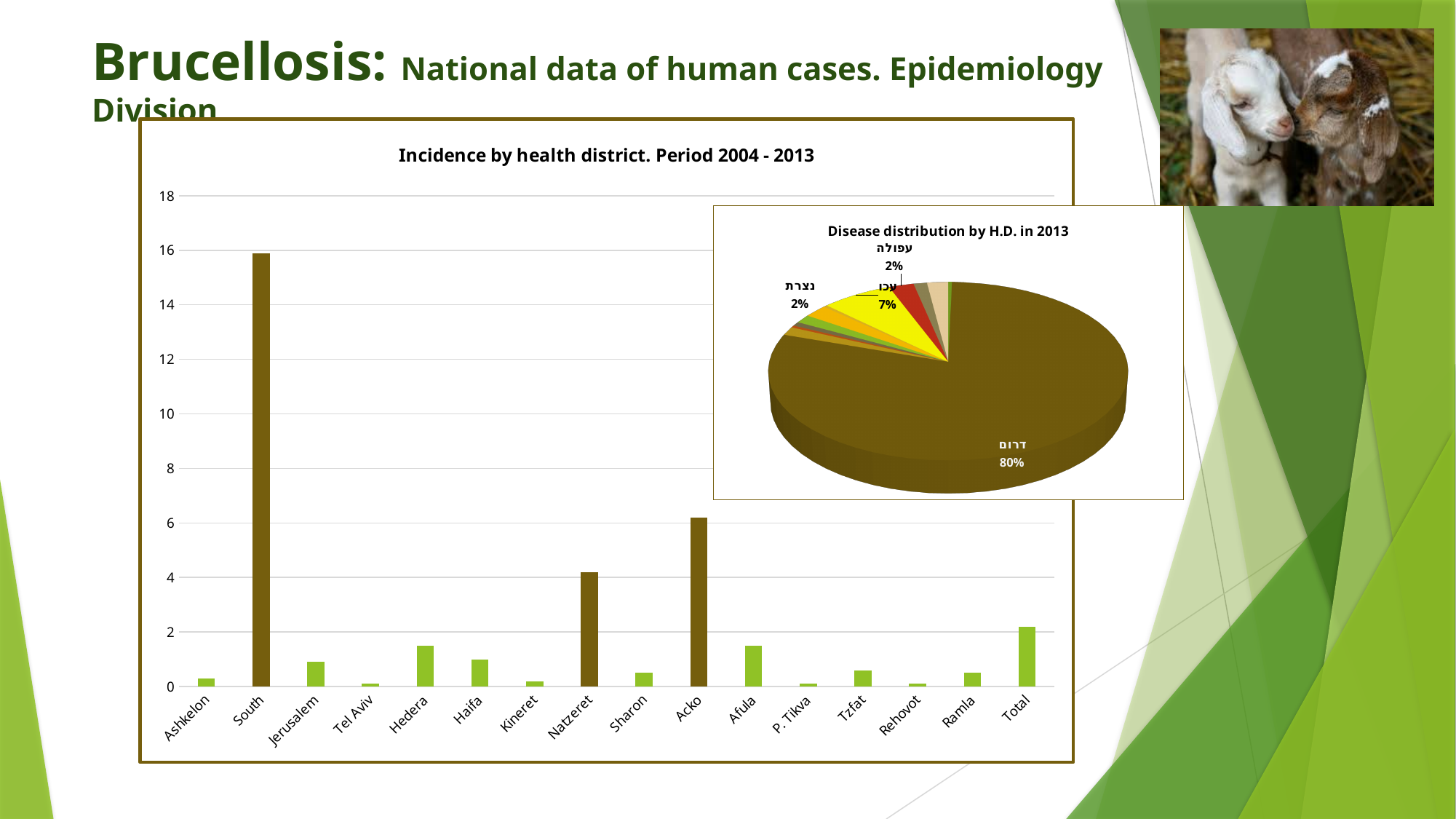
In the 'Disease distribution by H.D. in 2013' pie chart, what share does the דרום slice have? 80% What kind of chart is the 'Disease distribution by H.D. in 2013' chart? pie chart In the 'Disease distribution by H.D. in 2013' pie chart, which is larger, the share for עכו or the share for נצרת? עכו How many categories are shown on the x axis of the 'Incidence by health district. Period 2004 - 2013' chart? 16 What kind of chart is the 'Incidence by health district. Period 2004 - 2013' chart? bar chart In the 'Incidence by health district. Period 2004 - 2013' chart, which is larger, the value for South or the value for Acko? South In the 'Incidence by health district. Period 2004 - 2013' chart, is the value for Acko greater or less than 4? greater In the 'Incidence by health district. Period 2004 - 2013' chart, is the value for South greater or less than 14? greater In the 'Incidence by health district. Period 2004 - 2013' chart, is the value for Hedera greater or less than 2? less In the 'Incidence by health district. Period 2004 - 2013' chart, which is larger, the value for Natzeret or the value for Acko? Acko In the 'Incidence by health district. Period 2004 - 2013' chart, which health district has the highest value? South